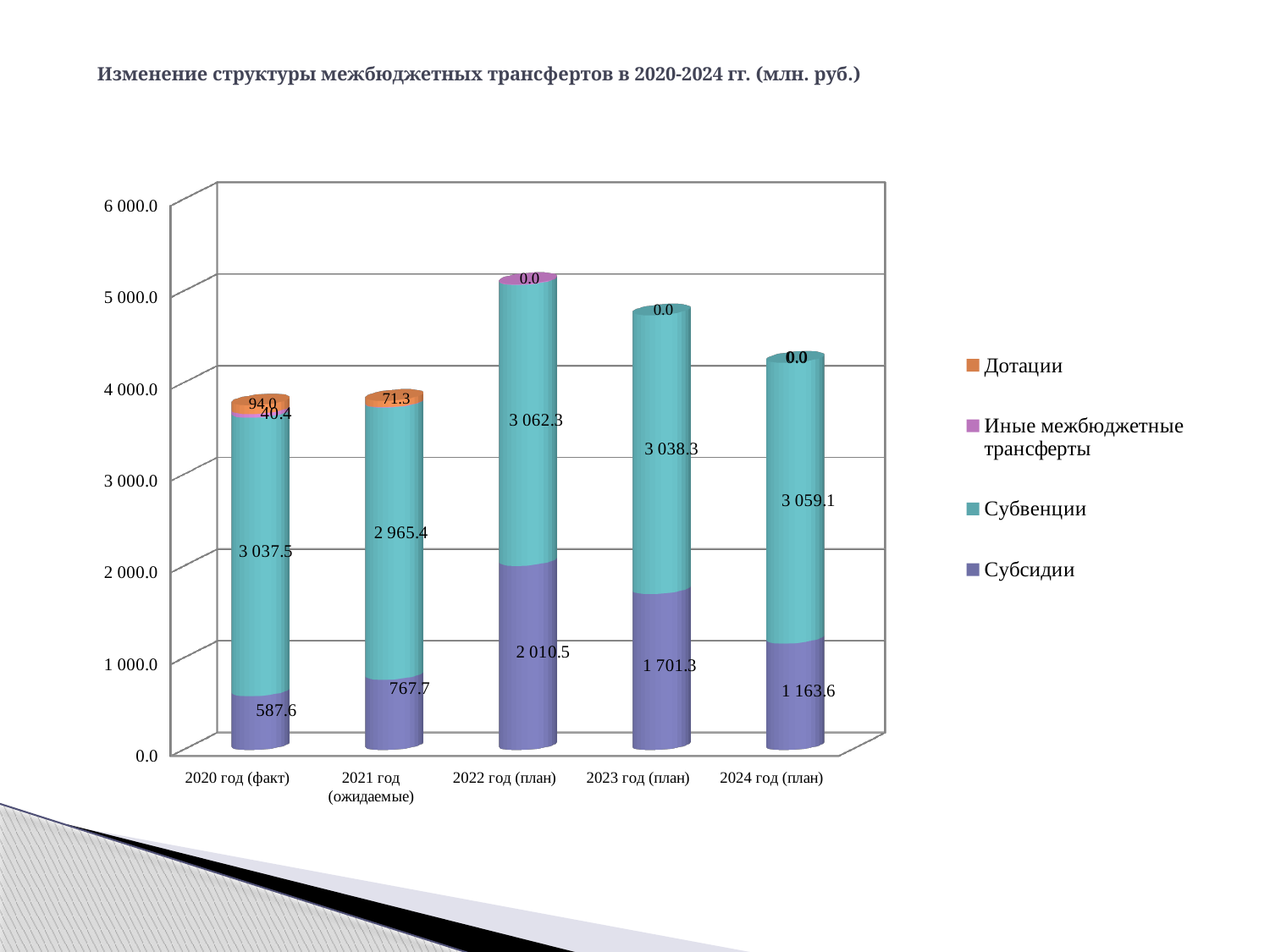
What is the value of Субвенции for 2021 год (ожидаемые)? 2 965.4 What is the value of Субсидии for 2020 год (факт)? 587.6 In which year is the Субсидии value the lowest? 2020 год (факт) In which year is the Субсидии value the highest? 2022 год (план) What is the value of Субсидии for 2024 год (план)? 1 163.6 What is the difference between the Субсидии values for 2022 год (план) and 2020 год (факт)? 1 422.9 Is the total height of the bar for 2024 год (план) greater or less than 5 000.0? less How many year categories are shown on the x axis? 5 How many series does the legend list? 4 What type of chart is shown on the slide? Stacked bar chart What is the value of Дотации for 2020 год (факт)? 94.0 Which is larger: Субсидии for 2023 год (план) or Субсидии for 2024 год (план)? 2023 год (план)